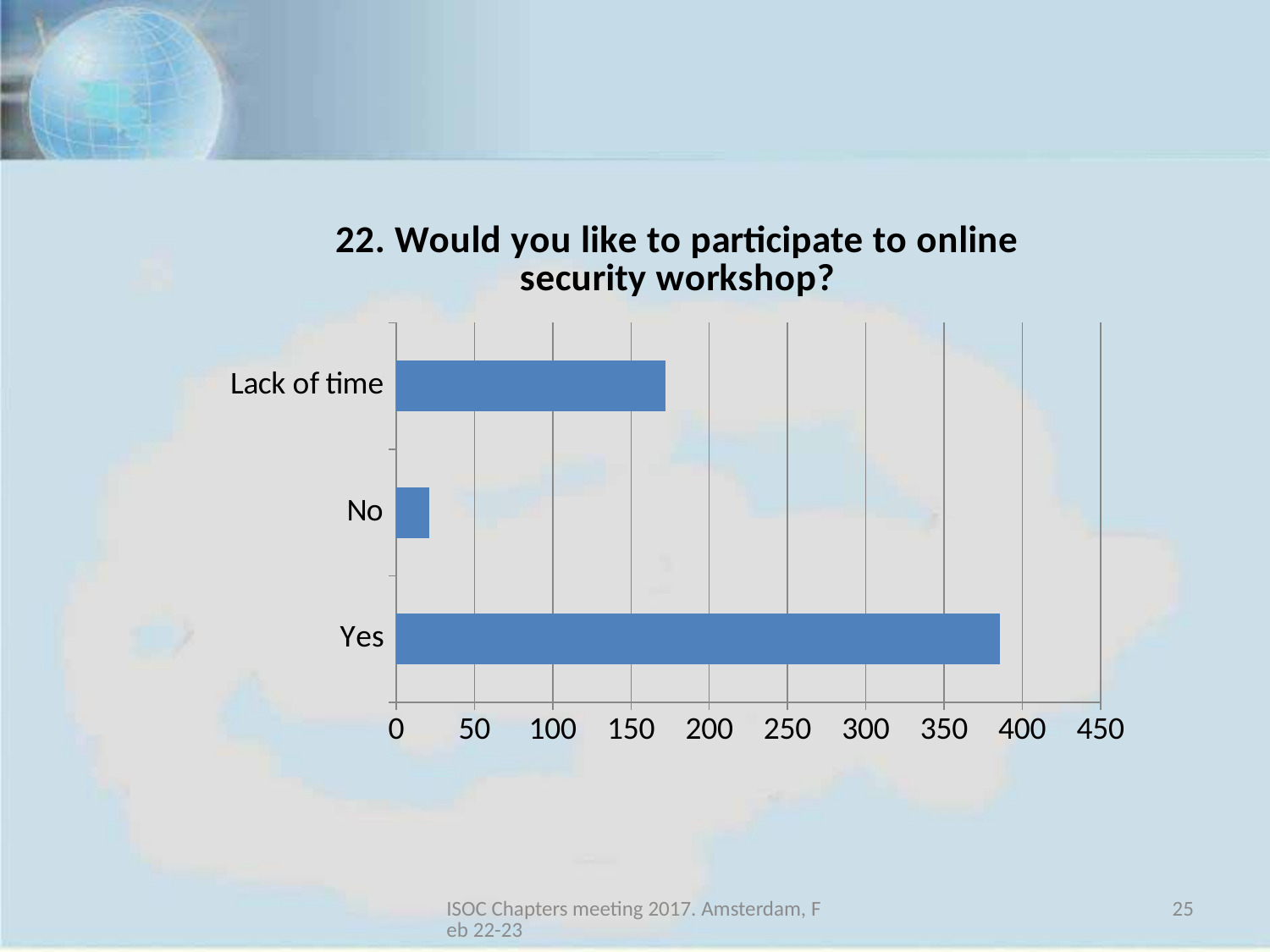
Is the value for No greater or less than 50? less Is the value for Yes greater or less than 400? less Which category has the highest value? Yes Which is larger, the value for Yes or the value for Lack of time? Yes What kind of chart is shown on the slide? bar chart What is the title of the chart? 22. Would you like to participate to online security workshop? Is the value for Lack of time greater or less than 150? greater What is the highest value shown on the horizontal axis? 450 How many categories are plotted in the chart? 3 Which category has the lowest value? No Which is larger, the value for Lack of time or the value for No? Lack of time